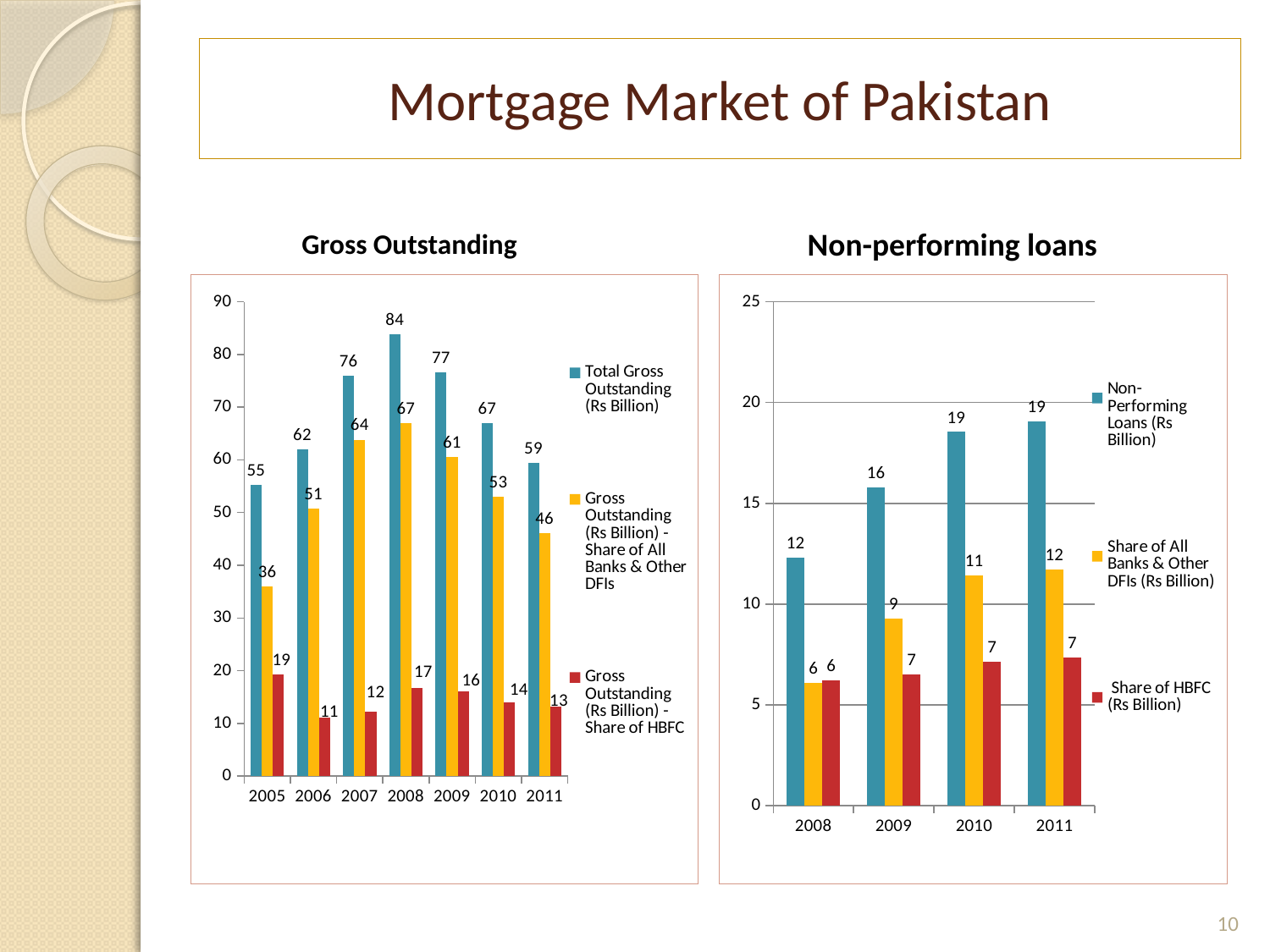
In the Non-performing loans chart, how many series does the legend list? 3 In the Non-performing loans chart, do the Non-Performing Loans values rise or fall from 2008 to 2010? rise In the Gross Outstanding chart, what is the Gross Outstanding - Share of HBFC value for 2005? 19 What kind of chart is the Gross Outstanding chart? bar chart In the Gross Outstanding chart, what is the Total Gross Outstanding value for 2008? 84 In the Gross Outstanding chart, which year has the highest Total Gross Outstanding? 2008 In the Non-performing loans chart, what is the Share of All Banks & Other DFIs value for 2011? 12 In the Non-performing loans chart, which is larger in 2010: Share of All Banks & Other DFIs or Share of HBFC? Share of All Banks & Other DFIs In the Gross Outstanding chart, which year has the lowest Gross Outstanding - Share of HBFC? 2006 In the Gross Outstanding chart, how many years are shown on the x axis? 7 In the Non-performing loans chart, what is the Non-Performing Loans value for 2009? 16 In the Gross Outstanding chart, what is the difference between Total Gross Outstanding in 2008 and in 2011? 25